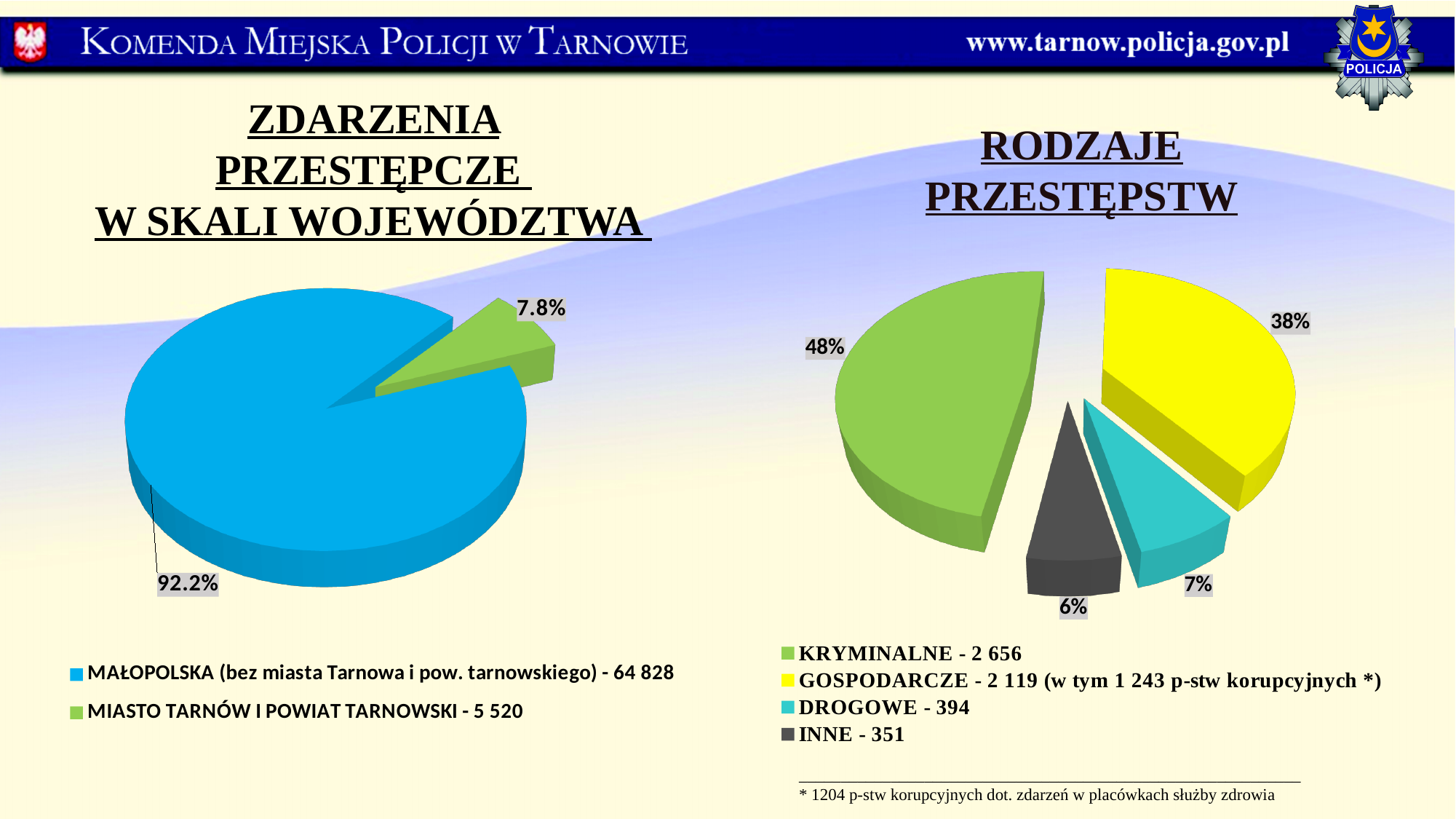
In the 'RODZAJE PRZESTĘPSTW' chart, what share of the pie is GOSPODARCZE? 38% What kind of chart is the 'ZDARZENIA PRZESTĘPCZE W SKALI WOJEWÓDZTWA' chart? Pie chart In the 'RODZAJE PRZESTĘPSTW' chart, which category has the largest share? KRYMINALNE In the 'RODZAJE PRZESTĘPSTW' chart, how many categories does the legend list? 4 In the 'RODZAJE PRZESTĘPSTW' chart, what value is given in the legend for DROGOWE? 394 In the 'ZDARZENIA PRZESTĘPCZE W SKALI WOJEWÓDZTWA' chart, what share of the pie is MIASTO TARNÓW I POWIAT TARNOWSKI? 7.8% In the 'RODZAJE PRZESTĘPSTW' chart, which category has the smallest share? INNE How many slices does the 'ZDARZENIA PRZESTĘPCZE W SKALI WOJEWÓDZTWA' pie chart have? 2 In the 'ZDARZENIA PRZESTĘPCZE W SKALI WOJEWÓDZTWA' chart, what value is given in the legend for MIASTO TARNÓW I POWIAT TARNOWSKI? 5 520 In the 'ZDARZENIA PRZESTĘPCZE W SKALI WOJEWÓDZTWA' chart, what value is given in the legend for MAŁOPOLSKA (bez miasta Tarnowa i pow. tarnowskiego)? 64 828 In the 'ZDARZENIA PRZESTĘPCZE W SKALI WOJEWÓDZTWA' chart, what share of the pie is MAŁOPOLSKA (bez miasta Tarnowa i pow. tarnowskiego)? 92.2% In the 'RODZAJE PRZESTĘPSTW' chart, what is the difference between the KRYMINALNE and GOSPODARCZE values shown in the legend? 537